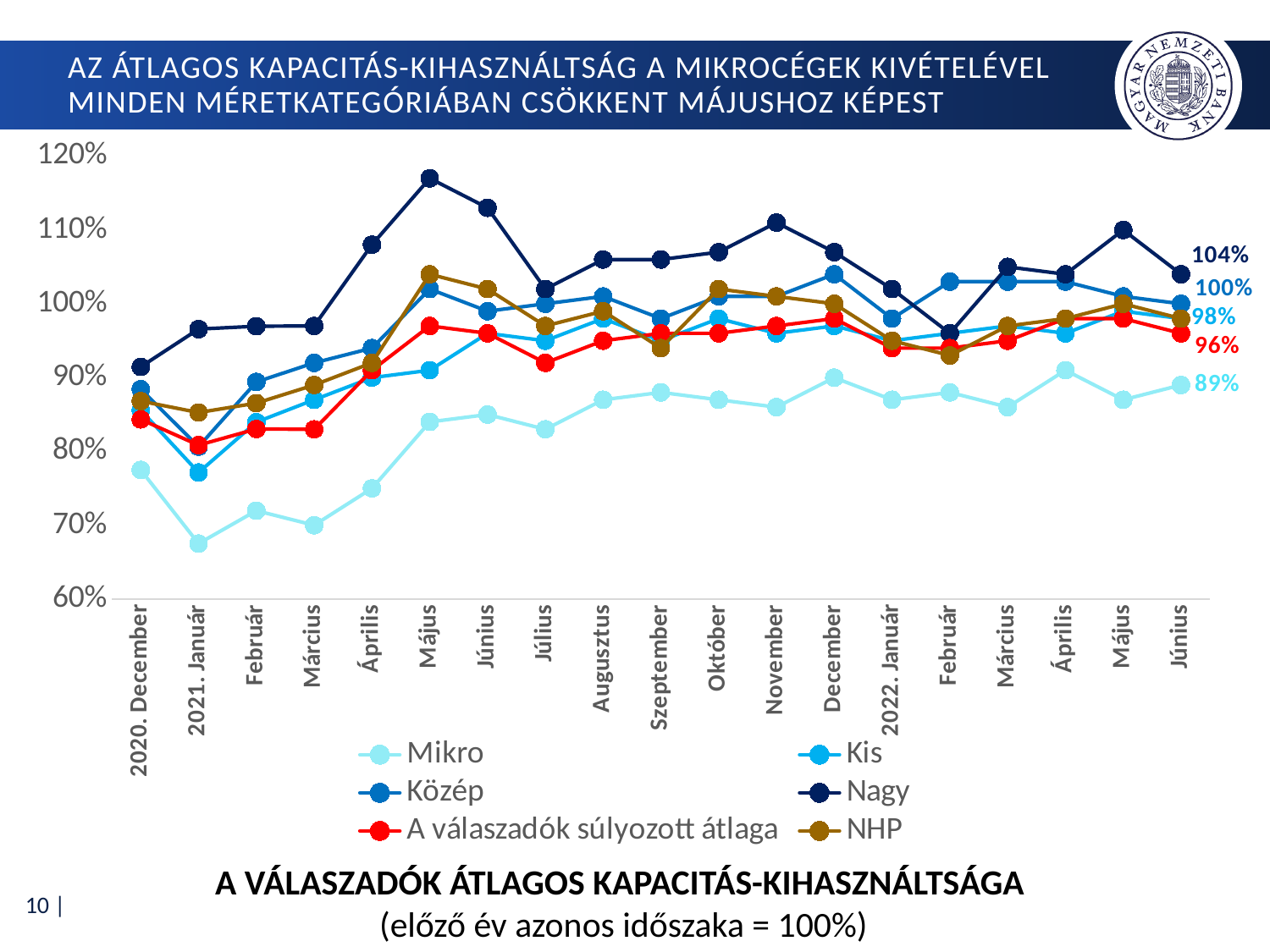
What is the value for Közép in 2022 Június? 100% What is the value for A válaszadók súlyozott átlaga in 2022 Június? 96% Which series has the lowest value in 2022 Június? Mikro What is the value for Mikro in 2022 Június? 89% How many months (points) are shown along the x axis? 19 How many series does the legend list? 6 What kind of chart is shown on the slide? line chart Is the value for Mikro in 2021 Január greater or less than 70%? less What is the difference between the Nagy and Mikro values in 2022 Június? 15 percentage points What is the value for Nagy in 2022 Június? 104% Which series has the highest value in 2022 Június? Nagy Is the value for Nagy in 2021 Május greater or less than 110%? greater